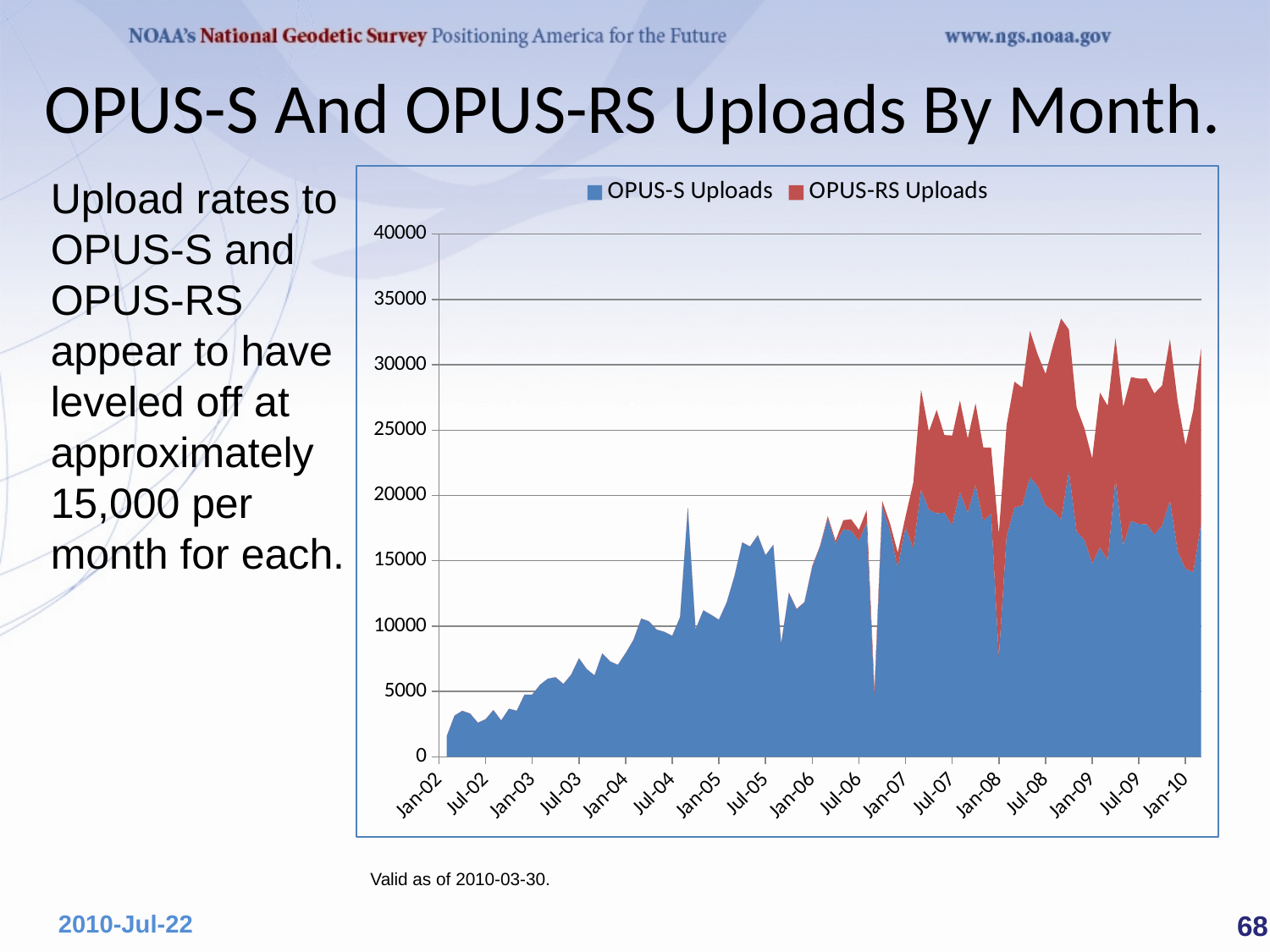
Which is larger: OPUS-S Uploads at Jan-02 or OPUS-S Uploads at Jan-10? Jan-10 What is the highest value shown on the chart's vertical axis? 40000 Is the value for OPUS-S Uploads at Jan-04 greater or less than 10000? less Is the value for OPUS-S Uploads at Jan-02 greater or less than 5000? less What kind of chart is shown on the slide? Stacked area chart Overall, do OPUS-S Uploads rise or fall from Jan-02 to Jan-10? Rise How many date labels are shown along the chart's horizontal axis? 17 What are the two series named in the chart legend? OPUS-S Uploads and OPUS-RS Uploads Is the combined (stacked) total of OPUS-S and OPUS-RS Uploads at its peak near Jul-08 greater or less than 30000? greater Which colour represents OPUS-RS Uploads in the chart? Red How many series does the chart legend list? 2